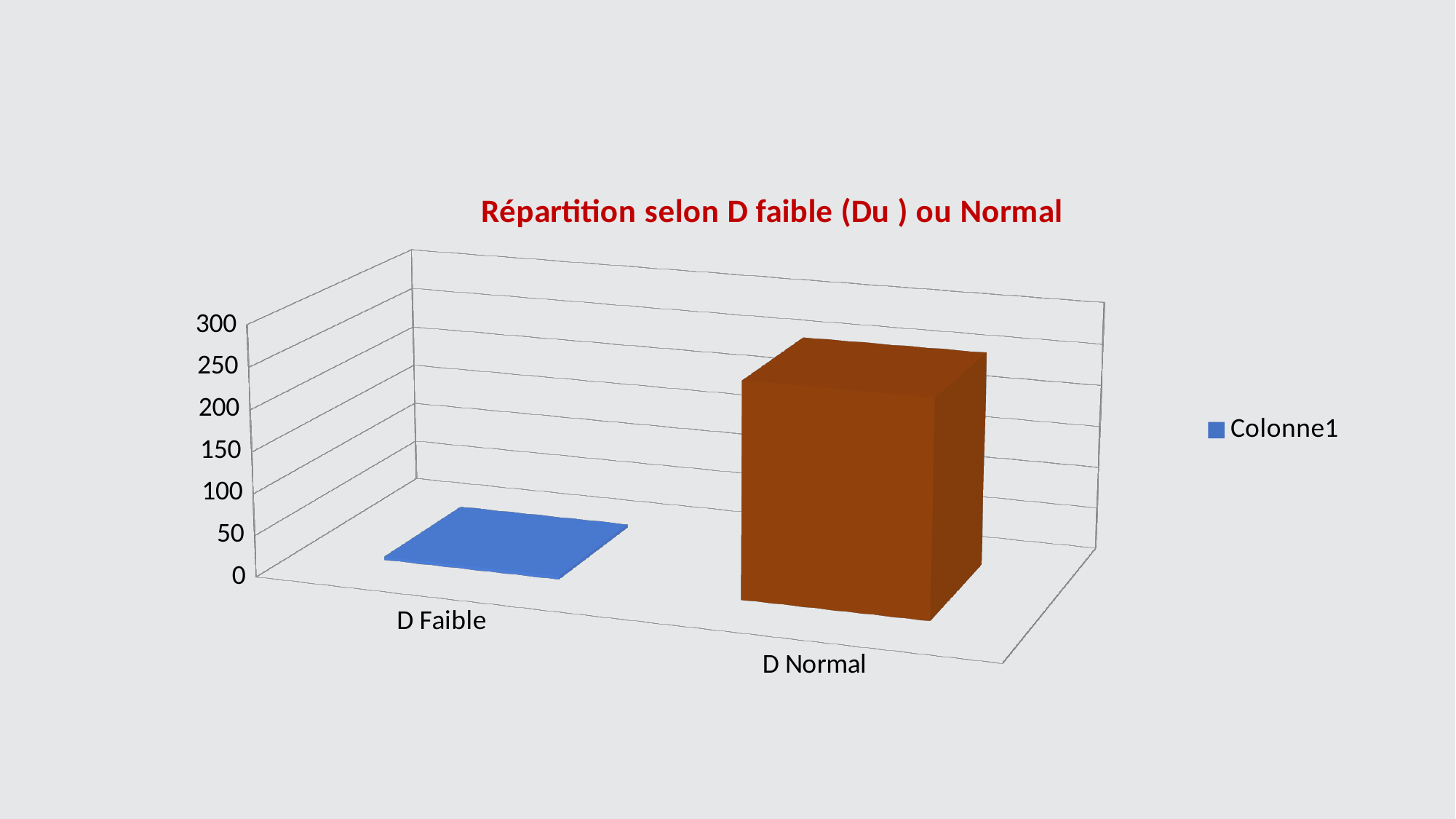
Which category has the lowest value? D Faible What is the name of the series shown in the legend? Colonne1 Is the value for D Faible greater or less than 50? less Is the value for D Normal greater or less than 150? greater What kind of chart is shown on the slide? bar chart What is the title of the chart? Répartition selon D faible (Du ) ou Normal Which is larger, the value for D Faible or the value for D Normal? D Normal How many series does the legend list? 1 Which category has the highest value? D Normal How many categories are plotted in the chart? 2